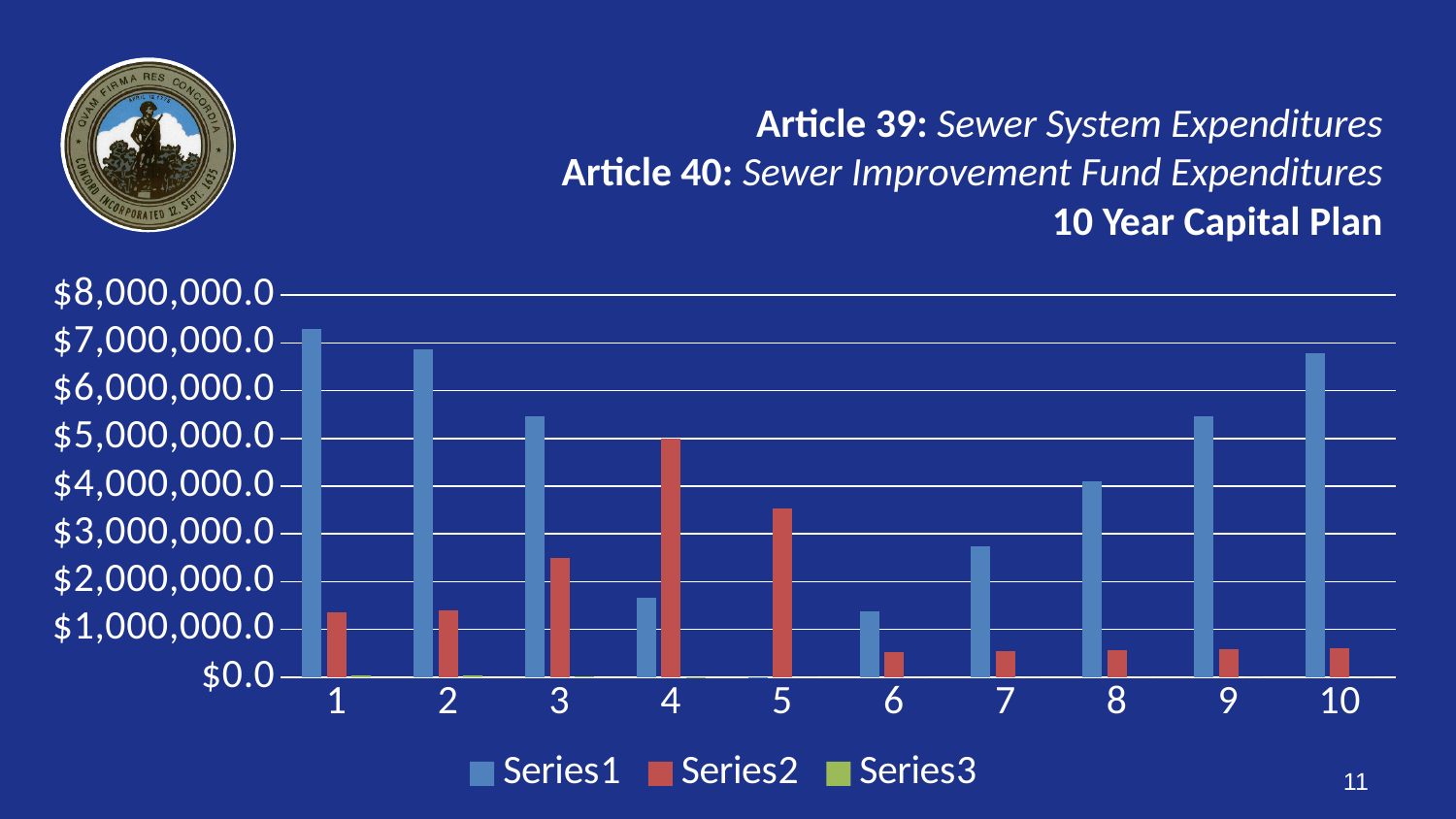
Which is larger for category 9: the Series1 value or the Series2 value? Series1 Is the Series2 value for category 5 greater or less than $3,000,000.0? greater Which is larger for category 4: the Series1 value or the Series2 value? Series2 Which category has the highest Series1 value? 1 Is the Series2 value for category 6 greater or less than $1,000,000.0? less How many categories are shown along the x axis of the chart? 10 How many series does the chart's legend list? 3 What kind of chart is shown on the slide? Bar chart Is the Series1 value for category 1 greater or less than $7,000,000.0? greater Which category has the highest Series2 value? 4 What colour are the Series2 bars in the chart? Red